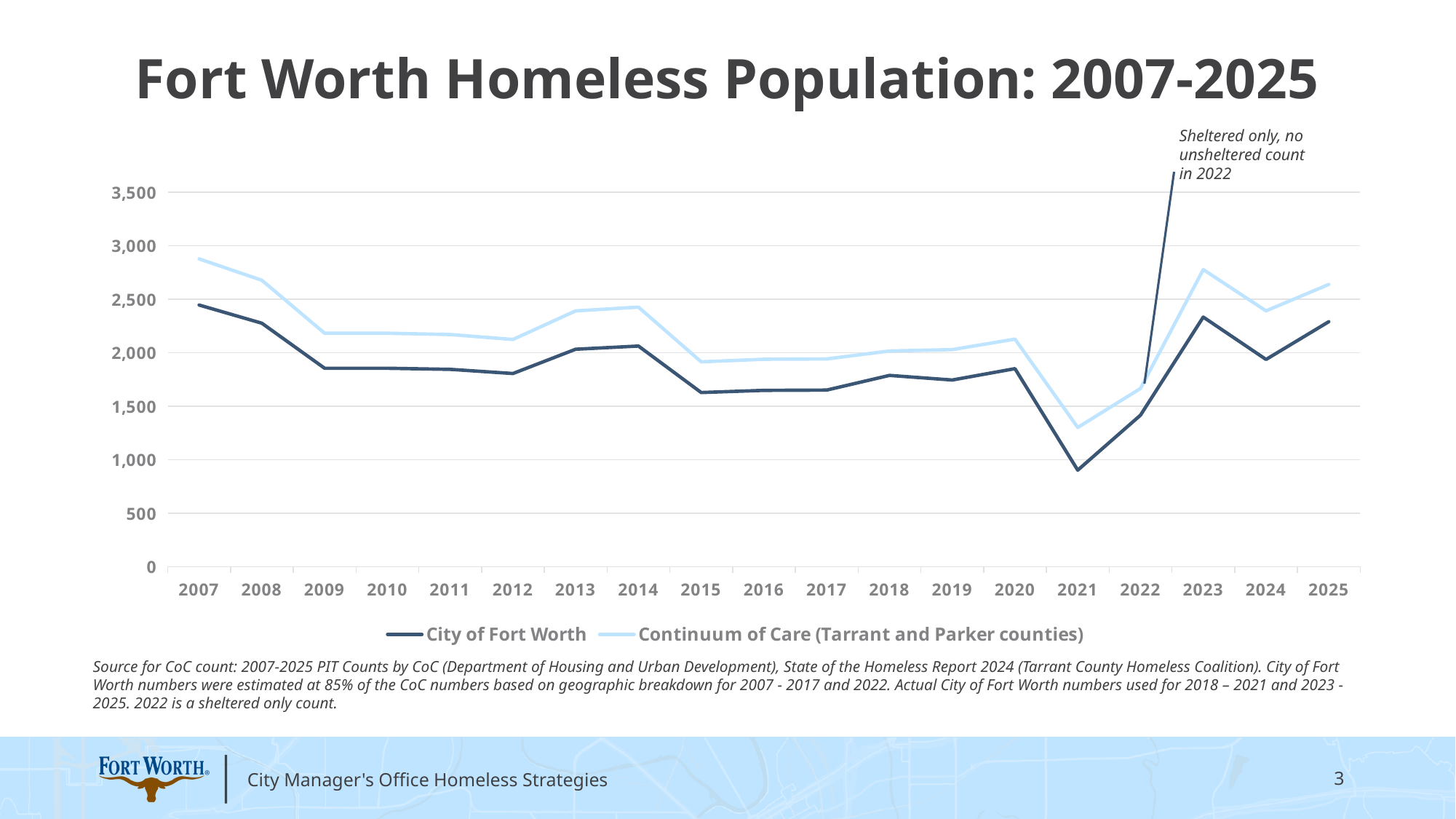
Is the City of Fort Worth value for 2021 greater or less than 1,000? less In 2025, which series has the larger value: City of Fort Worth or Continuum of Care (Tarrant and Parker counties)? Continuum of Care (Tarrant and Parker counties) What kind of chart is shown on the slide? line chart In which year is the City of Fort Worth value lowest? 2021 Is the City of Fort Worth value for 2023 greater or less than 2,000? greater How many years are plotted along the x axis? 19 Is the Continuum of Care (Tarrant and Parker counties) value for 2007 greater or less than 2,500? greater In which year is the Continuum of Care (Tarrant and Parker counties) value lowest? 2021 How many series does the legend list? 2 Do the City of Fort Worth values rise or fall from 2007 to 2009? fall What is the title of the chart? Fort Worth Homeless Population: 2007-2025